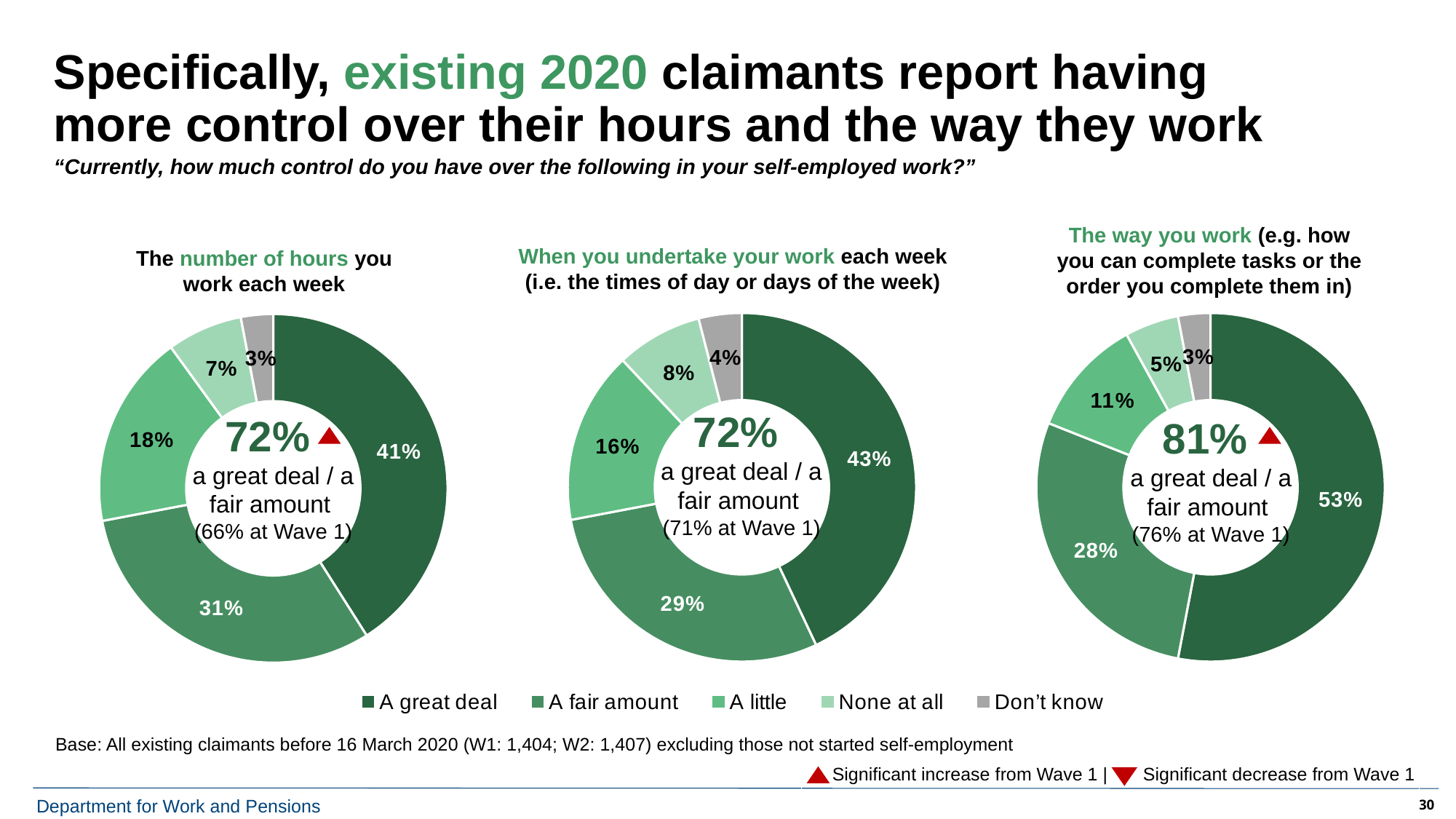
Which is larger in the 'The way you work' chart: the 'A little' share or the 'None at all' share? A little In the 'The number of hours you work each week' chart, which response category has the smallest share? Don't know What is the combined 'a great deal / a fair amount' figure shown in the centre of the 'The way you work' chart? 81% What type of chart is used to show the responses on this slide? Donut (pie) chart In the 'The way you work' chart, which response category has the largest share? A great deal In the 'When you undertake your work each week' chart, what percentage said 'A little'? 16% What was the Wave 1 'a great deal / a fair amount' figure for the 'The number of hours you work each week' chart? 66% How many response categories does the legend list? 5 How many charts are shown on the slide? 3 In the 'The way you work' chart, what percentage said 'A fair amount'? 28% In the 'When you undertake your work each week' chart, what is the difference between the 'A great deal' and 'A fair amount' shares? 14% In the 'The number of hours you work each week' chart, what percentage said 'A great deal'? 41%